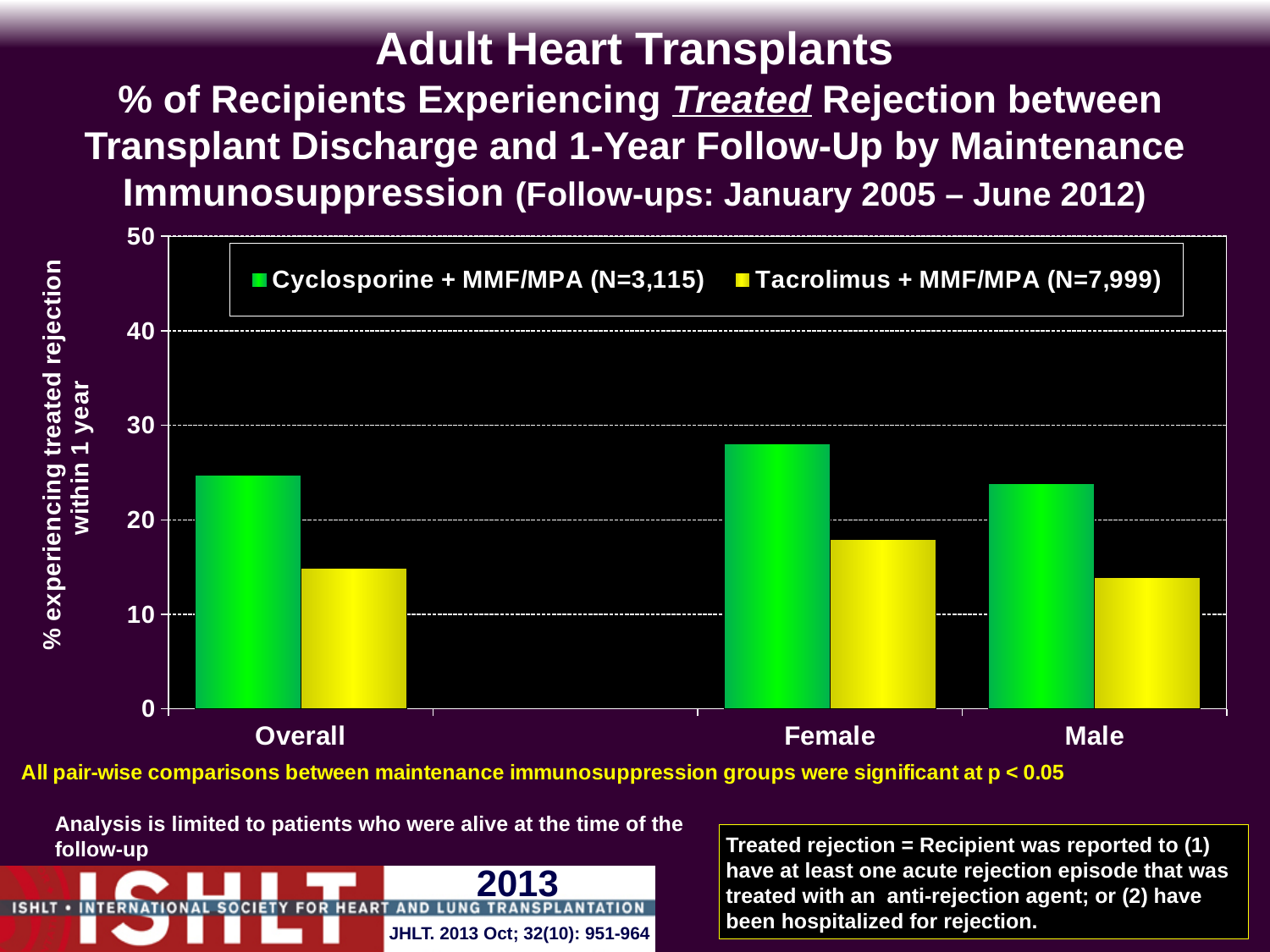
Is the value for Tacrolimus + MMF/MPA in the Overall category greater or less than 20? less Which category has the highest value for Cyclosporine + MMF/MPA? Female What kind of chart is shown on the slide? Bar chart Is the value for Cyclosporine + MMF/MPA in the Female category greater or less than 30? less Is the value for Cyclosporine + MMF/MPA in the Overall category greater or less than 20? greater Which category has the highest value for Tacrolimus + MMF/MPA? Female How many series does the legend list? 2 What is the N shown in the legend for Tacrolimus + MMF/MPA? 7,999 How many categories are shown on the x axis? 3 In the Female category, which series has the larger value: Cyclosporine + MMF/MPA or Tacrolimus + MMF/MPA? Cyclosporine + MMF/MPA